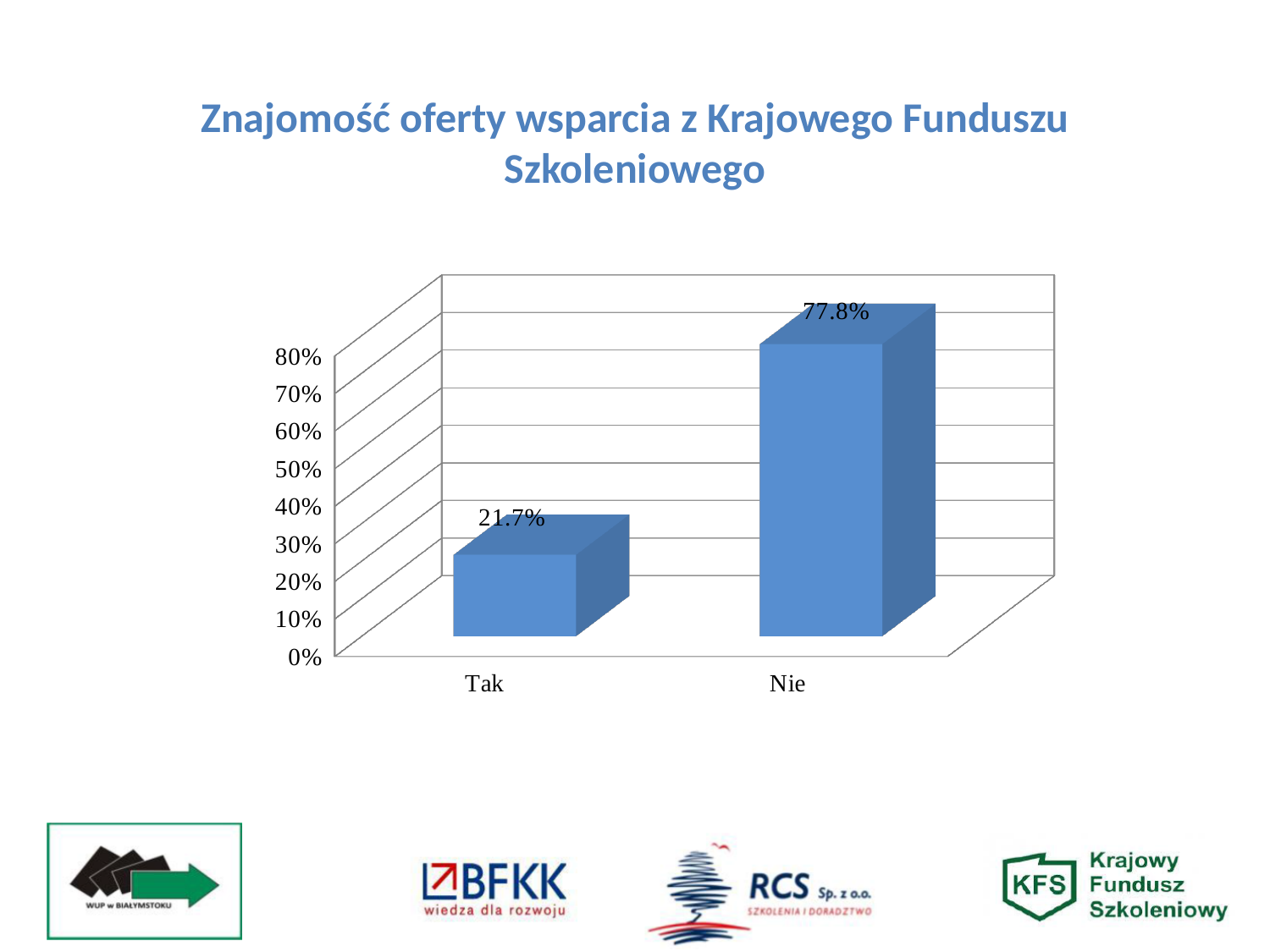
Which category has the lowest value? Tak What kind of chart is shown on the slide? bar chart What is the value for Tak? 21.7% Which is larger, the value for Tak or the value for Nie? Nie What is the value for Nie? 77.8% Which category has the highest value? Nie What is the title of the slide? Znajomość oferty wsparcia z Krajowego Funduszu Szkoleniowego How many categories are shown on the x axis? 2 What is the difference between the values for Nie and Tak? 56.1% What colour are the bars in the chart? blue Is the value for Tak greater or less than 30%? less Is the value for Nie greater or less than 70%? greater